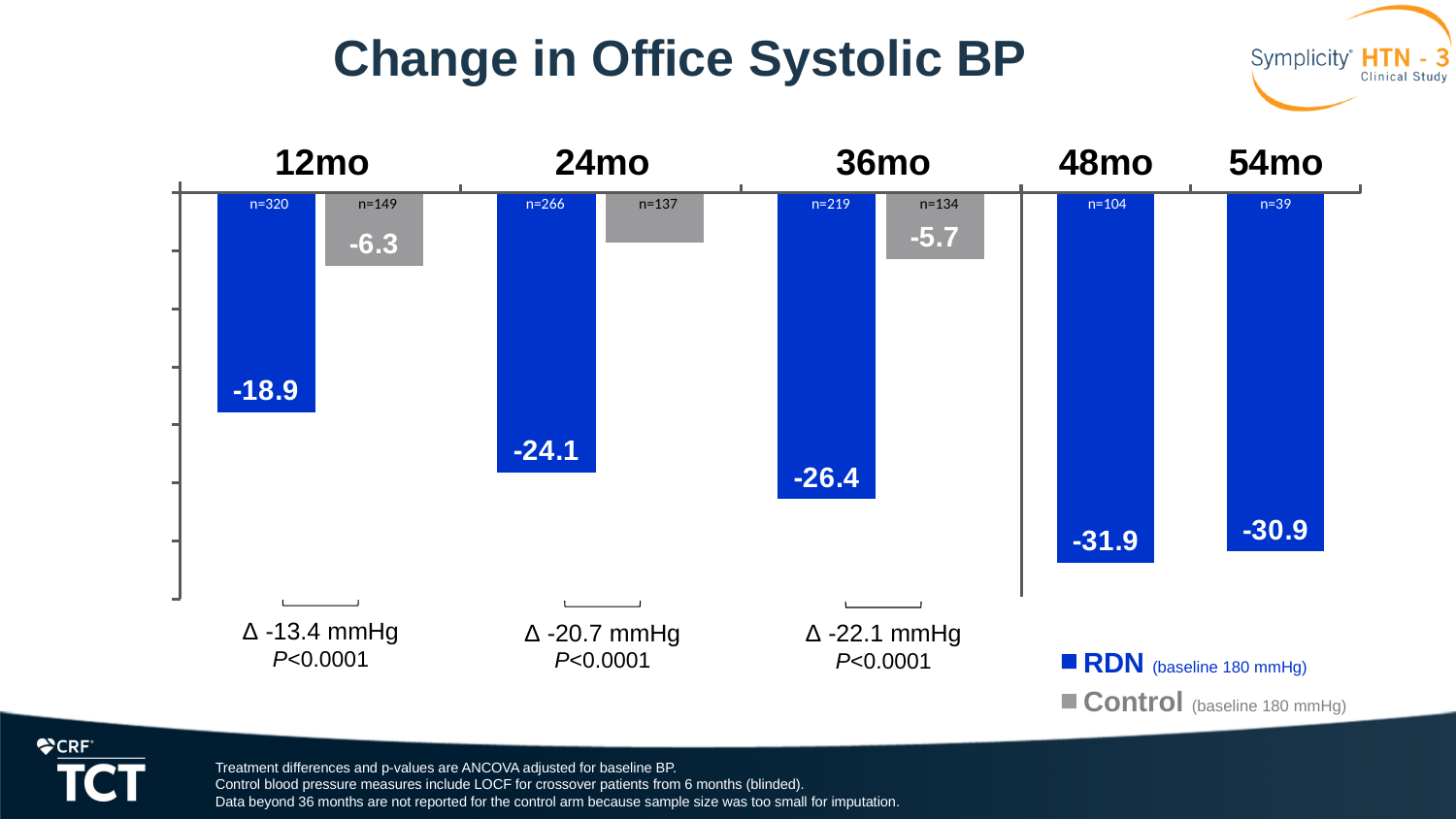
How many series does the legend list? 2 What is the difference between the RDN values at 54 months and 12 months? 12.0 At which time point does the RDN group show the smallest reduction in office systolic BP? 12mo What is the treatment difference (Δ) between RDN and Control at 24 months? -20.7 mmHg What is the RDN value at 48 months? -31.9 What is the Control value at 12 months? -6.3 What kind of chart is shown on the slide? Bar chart Which group shows a larger reduction in office systolic BP at 36 months, RDN or Control? RDN At which time point does the RDN group show the largest reduction in office systolic BP? 48mo What is the change in office systolic BP for the RDN group at 12 months? -18.9 What is the change in office systolic BP for the Control group at 36 months? -5.7 How many time points are shown on the x axis? 5